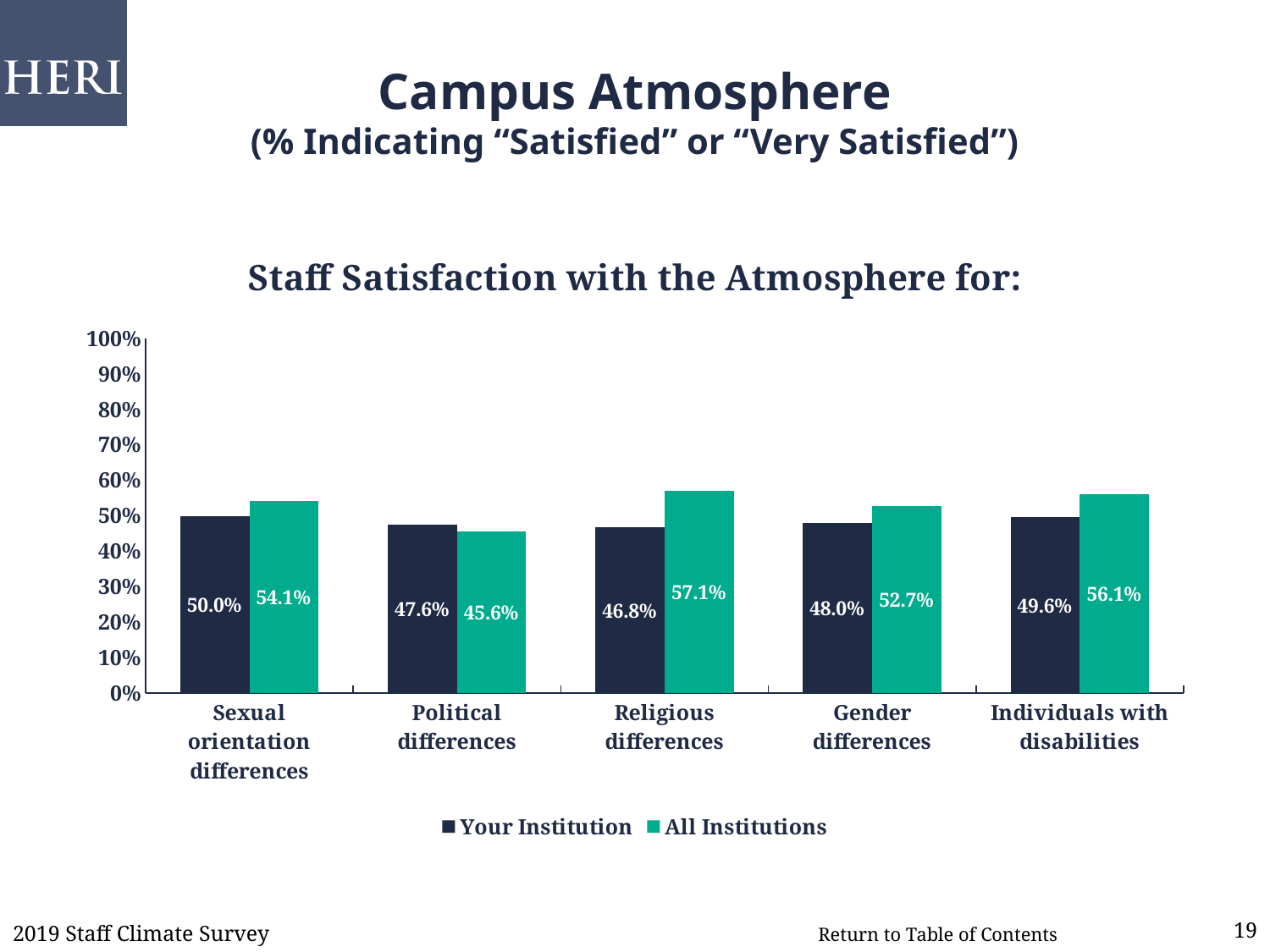
What is the value for All Institutions for Individuals with disabilities? 56.1% How many series does the legend list? 2 Which is larger for Political differences: Your Institution or All Institutions? Your Institution How many categories are shown on the x axis? 5 What is the value for Your Institution for Sexual orientation differences? 50.0% What is the difference between All Institutions and Your Institution for Religious differences? 10.3% What is the title of the chart? Staff Satisfaction with the Atmosphere for: Which category has the highest value for All Institutions? Religious differences Which category has the lowest value for Your Institution? Religious differences Is the value for All Institutions for Gender differences greater or less than 50%? greater What kind of chart is shown on the slide? Bar chart What is the value for Your Institution for Religious differences? 46.8%